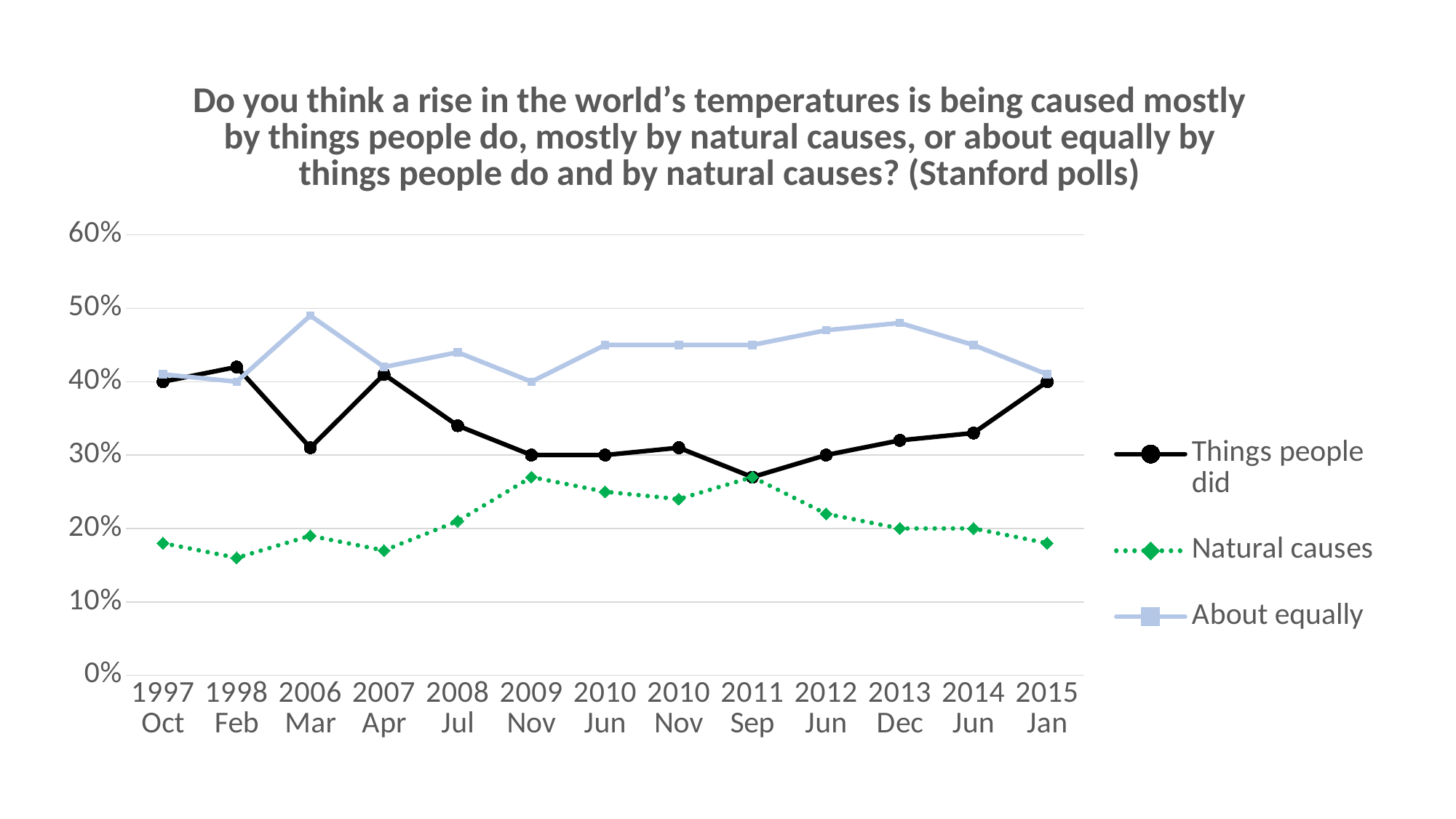
What is the value for "Things people did" in 2015 Jan? 40% What is the value for "About equally" in 2009 Nov? 40% Which series is plotted with a dotted green line? Natural causes Does the "Natural causes" line rise or fall from 2011 Sep to 2015 Jan? fall Is the value for "Things people did" in 2011 Sep greater or less than 30%? less Is the value for "About equally" in 2006 Mar greater or less than 40%? greater Which polling organisation is named in the chart title? Stanford polls How many series does the legend list? 3 In 2006 Mar, which is larger: "About equally" or "Things people did"? About equally What kind of chart is shown on the slide? line chart Is the value for "Natural causes" in 1998 Feb greater or less than 20%? less How many poll dates are plotted along the x axis? 13